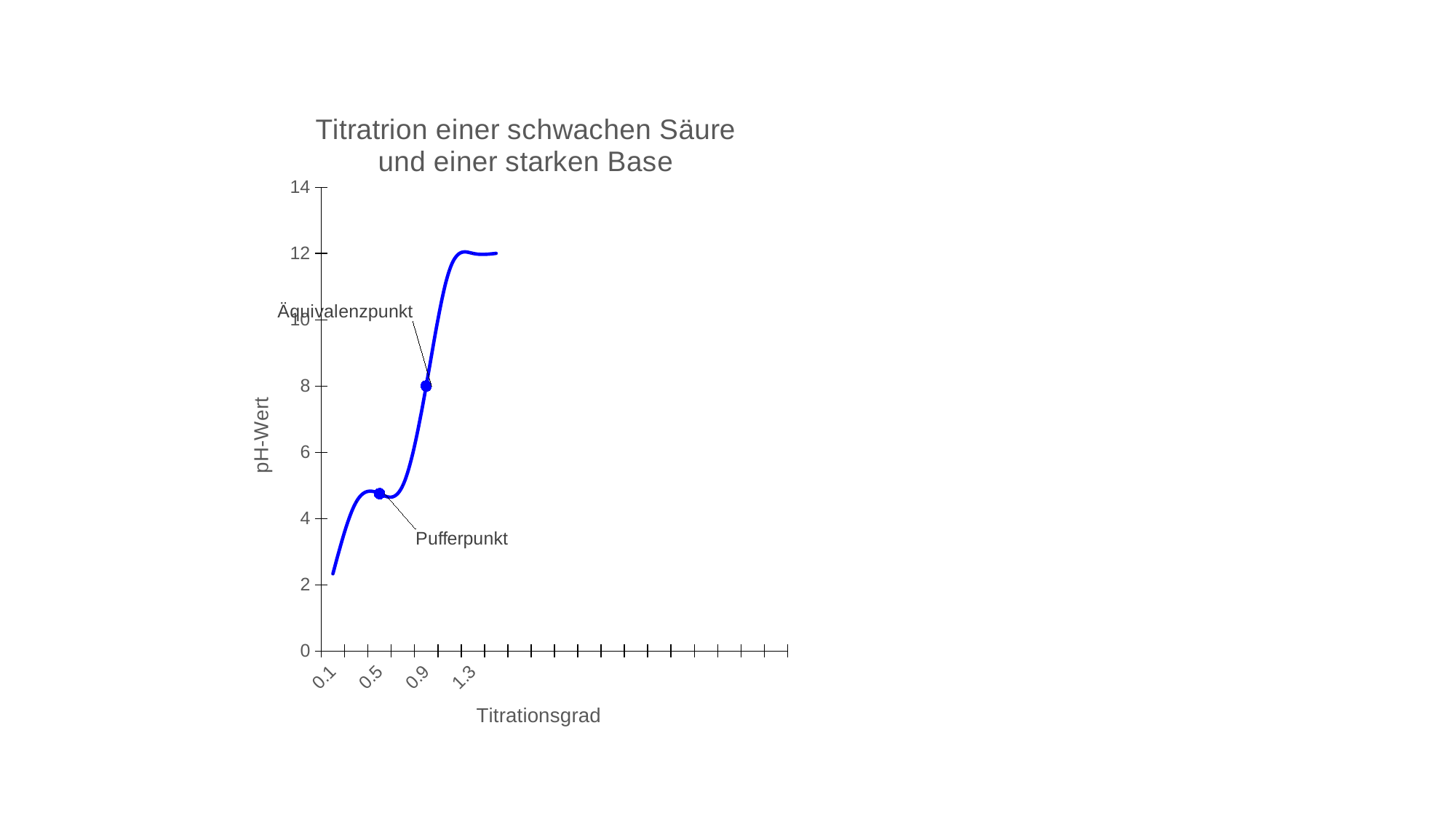
Does the pH-Wert rise or fall as the Titrationsgrad increases along the x axis? rise Is the pH-Wert at the Äquivalenzpunkt greater or less than 6? greater What is the title of the chart? Titratrion einer schwachen Säure und einer starken Base What kind of chart is shown on the slide? line chart Is the pH-Wert at the Pufferpunkt greater or less than 6? less Is the pH-Wert at the Äquivalenzpunkt greater or less than 10? less Which marked point has the higher pH-Wert, the Äquivalenzpunkt or the Pufferpunkt? Äquivalenzpunkt What is the label of the vertical axis? pH-Wert What is the pH-Wert at the Äquivalenzpunkt? 8 How many labelled points are marked on the curve? 2